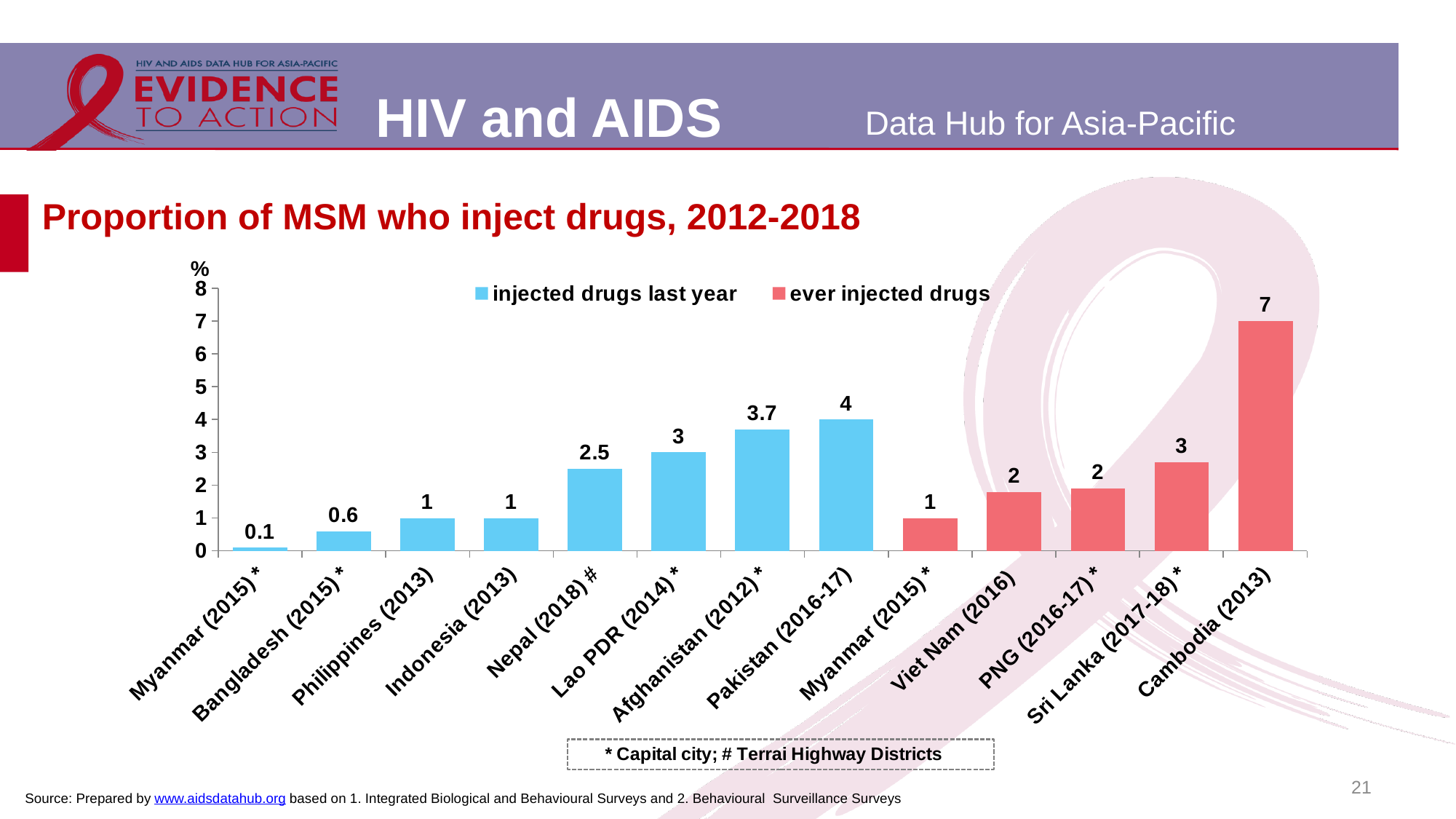
What is the value for Nepal (2018)? 2.5 What is the difference between the values for Cambodia (2013) and Sri Lanka (2017-18)? 4 How many series does the legend list? 2 What kind of chart is shown on the slide? bar chart Which is larger, the value for Afghanistan (2012) or the value for Lao PDR (2014)? Afghanistan (2012) What is the title of the chart? Proportion of MSM who inject drugs, 2012-2018 How many bars are plotted on the chart? 13 What is the value for Cambodia (2013) for ever injected drugs? 7 Which bar has the lowest value on the chart? Myanmar (2015), injected drugs last year Which country has the highest value on the chart? Cambodia (2013) What is the value for Pakistan (2016-17)? 4 What is the value for Bangladesh (2015)? 0.6